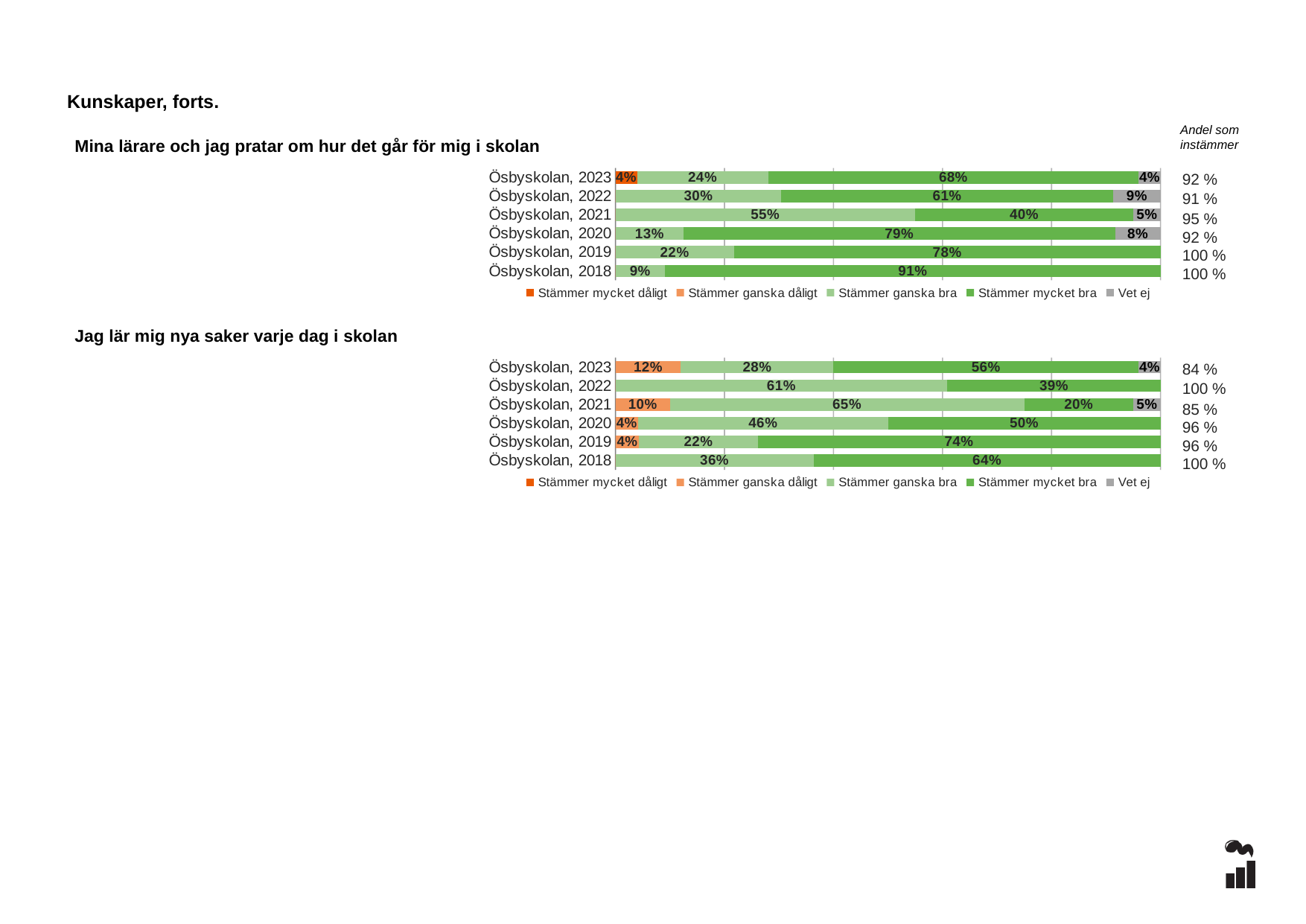
In the chart 'Jag lär mig nya saker varje dag i skolan', what is the 'Stämmer ganska dåligt' value for Ösbyskolan, 2023? 12% In the chart 'Mina lärare och jag pratar om hur det går för mig i skolan', what is the difference between the 'Stämmer mycket bra' values for Ösbyskolan, 2020 and Ösbyskolan, 2021? 39% In the chart 'Mina lärare och jag pratar om hur det går för mig i skolan', what is the 'Stämmer ganska bra' value for Ösbyskolan, 2021? 55% How many series does the legend of the chart 'Jag lär mig nya saker varje dag i skolan' list? 5 In the chart 'Mina lärare och jag pratar om hur det går för mig i skolan', what is the 'Stämmer mycket bra' value for Ösbyskolan, 2018? 91% In the chart 'Jag lär mig nya saker varje dag i skolan', what is the 'Stämmer ganska bra' value for Ösbyskolan, 2022? 61% In the chart 'Mina lärare och jag pratar om hur det går för mig i skolan', which year has the highest 'Stämmer mycket bra' value? Ösbyskolan, 2018 In the chart 'Mina lärare och jag pratar om hur det går för mig i skolan', what is the 'Vet ej' value for Ösbyskolan, 2022? 9% What kind of chart is 'Mina lärare och jag pratar om hur det går för mig i skolan'? Stacked bar chart In the chart 'Jag lär mig nya saker varje dag i skolan', is the 'Stämmer mycket bra' value larger for Ösbyskolan, 2019 or Ösbyskolan, 2018? Ösbyskolan, 2019 In the chart 'Jag lär mig nya saker varje dag i skolan', which year has the lowest 'Stämmer mycket bra' value? Ösbyskolan, 2021 In the chart 'Jag lär mig nya saker varje dag i skolan', what is the 'Andel som instämmer' value for Ösbyskolan, 2023? 84 %